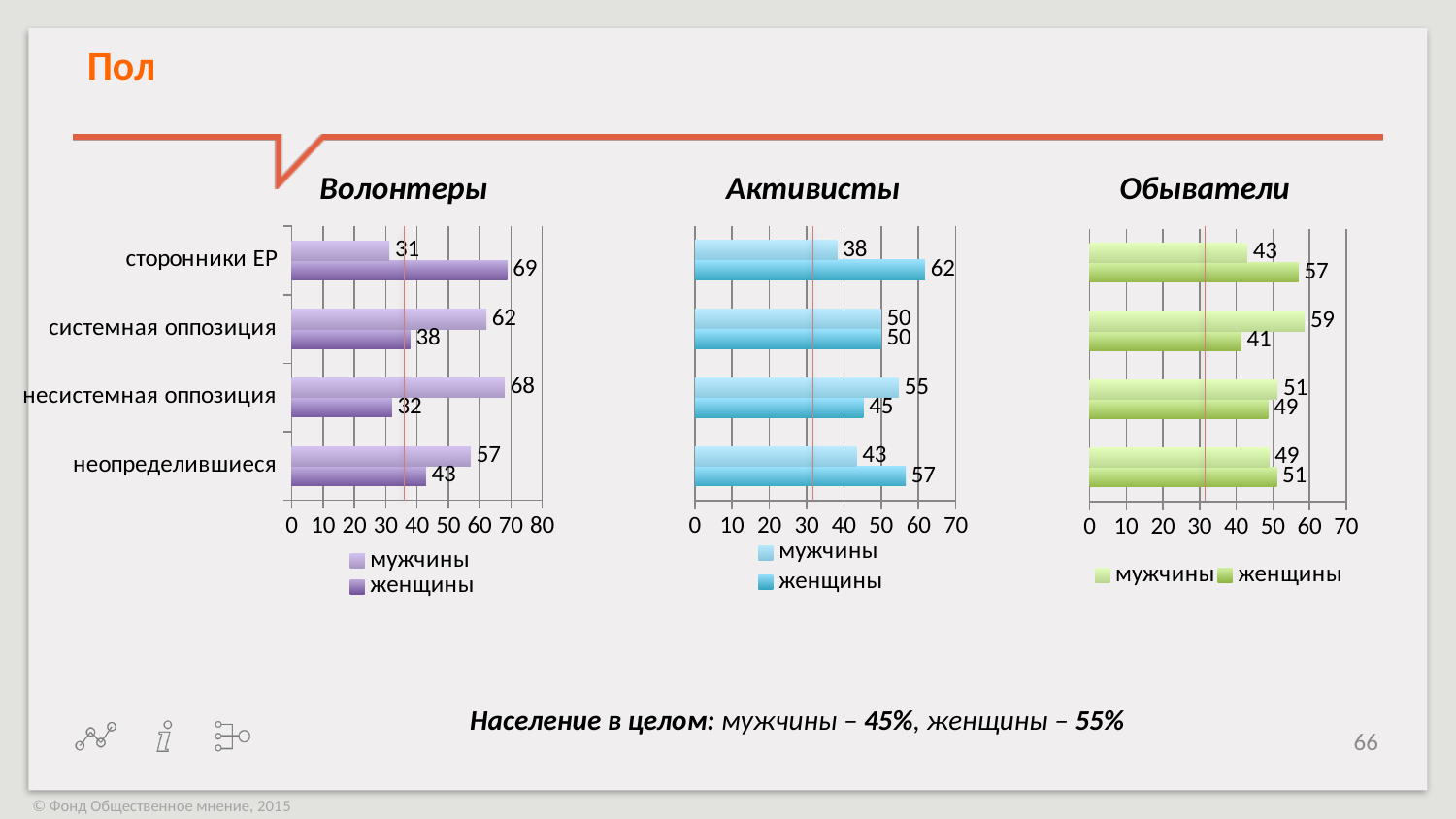
In the Активисты chart, what is the difference between женщины and мужчины among сторонники ЕР? 24 In the Обыватели chart, which category has the lowest value for мужчины? сторонники ЕР In the Волонтеры chart, which is larger for системная оппозиция: мужчины or женщины? мужчины How many series does the legend of the Обыватели chart list? 2 In the Волонтеры chart, what is the value for мужчины among несистемная оппозиция? 68 How many categories are shown in the Активисты chart? 4 In the Волонтеры chart, which category has the highest value for женщины? сторонники ЕР What type of chart is the Волонтеры chart? bar chart In the Обыватели chart, what is the value for женщины among системная оппозиция? 41 In the Волонтеры chart, what is the value for женщины among сторонники ЕР? 69 In the Активисты chart, what are the values for мужчины and женщины among системная оппозиция? 50 and 50 In the Активисты chart, what is the value for мужчины among сторонники ЕР? 38